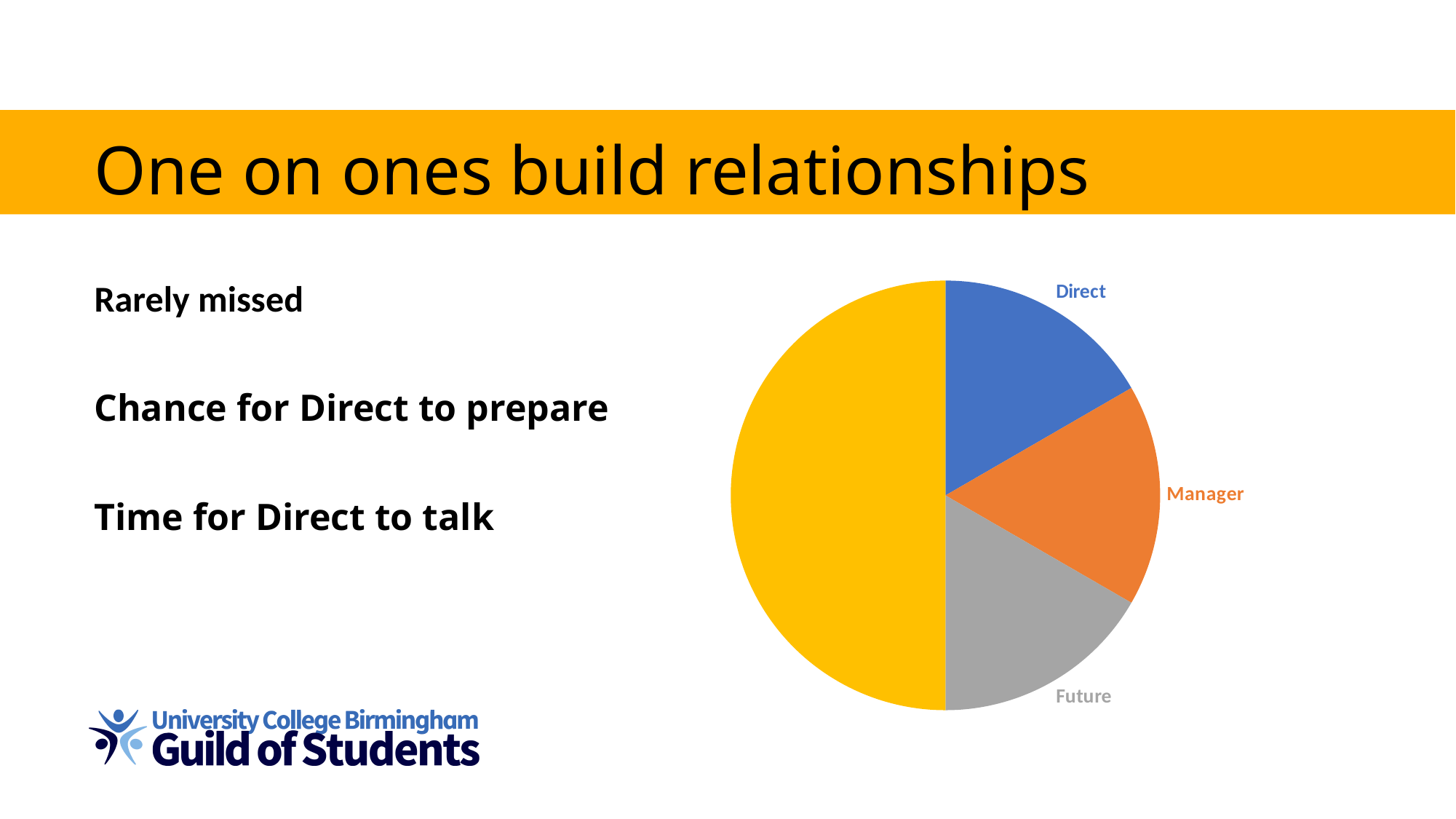
Is the Future slice larger or smaller than the unlabelled yellow slice? smaller How many slices does the pie chart have? 4 Is the Direct slice larger or smaller than the unlabelled yellow slice? smaller What colour is the Direct slice of the pie chart? blue Which slice labels are readable on the pie chart? Direct, Manager, Future What kind of chart is shown on the slide? pie chart